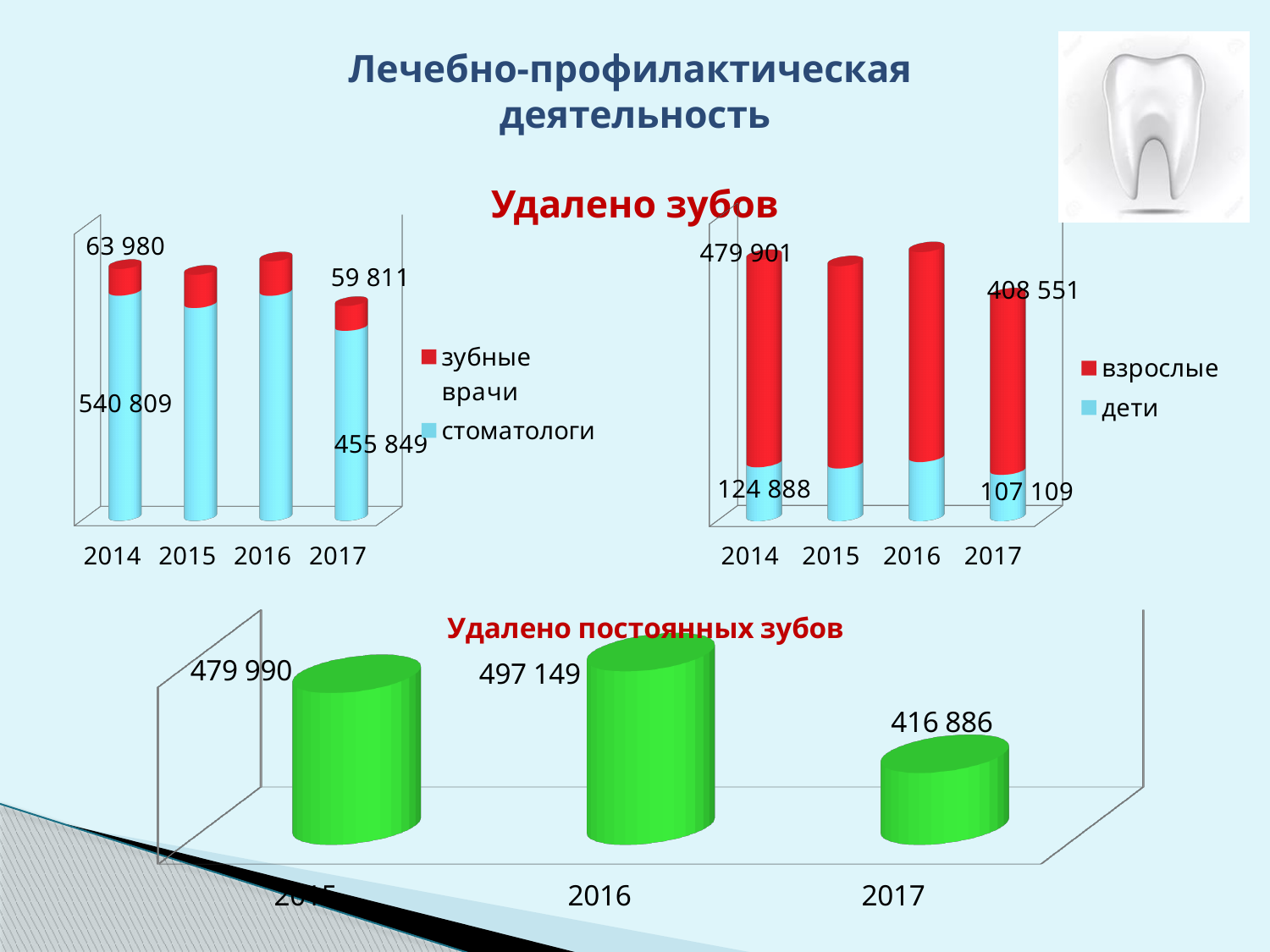
In the bottom chart 'Удалено постоянных зубов', which year has the highest value? 2016 How many series does the legend of the top-right chart list? 2 In the top-right chart, what is the value for 'дети' in 2017? 107 109 In the top-left chart, what is the value for 'зубные врачи' in 2017? 59 811 In the bottom chart 'Удалено постоянных зубов', what is the value for 2016? 497 149 How many years are shown in the bottom chart 'Удалено постоянных зубов'? 3 In the top-left chart, what is the total of the stacked bar for 2014? 604 789 In the bottom chart 'Удалено постоянных зубов', which year has the lowest value? 2017 In the top-left chart, what is the value for 'стоматологи' in 2014? 540 809 In the top-right chart, is the 'взрослые' value larger in 2014 or in 2017? 2014 In the bottom chart 'Удалено постоянных зубов', what is the difference between the 2016 and 2017 values? 80 263 In the top-right chart, what is the value for 'взрослые' in 2014? 479 901